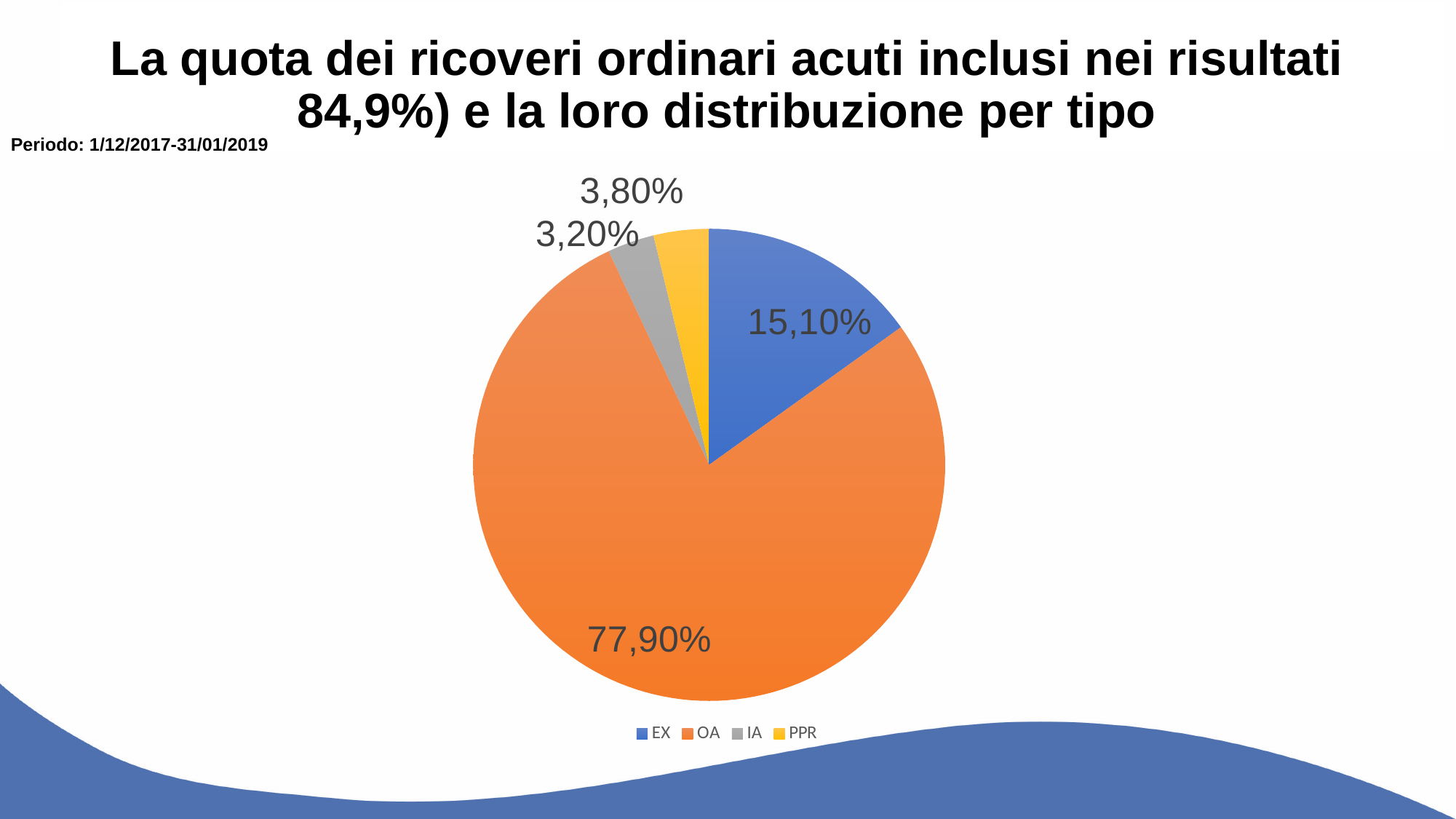
How many categories does the pie chart show? 4 Which category has the largest slice of the pie? OA What kind of chart is shown on the slide? pie chart Which colour represents OA in the pie chart? orange What share of the pie does PPR account for? 3,80% What share of the pie does EX account for? 15,10% What is the difference in percentage points between the OA slice and the EX slice? 62,80 What share of the pie does IA account for? 3,20% Which is larger, the slice for EX or the slice for PPR? EX What period is stated on the slide for the data? 1/12/2017-31/01/2019 What share of the pie does OA account for? 77,90% Which category has the smallest slice of the pie? IA